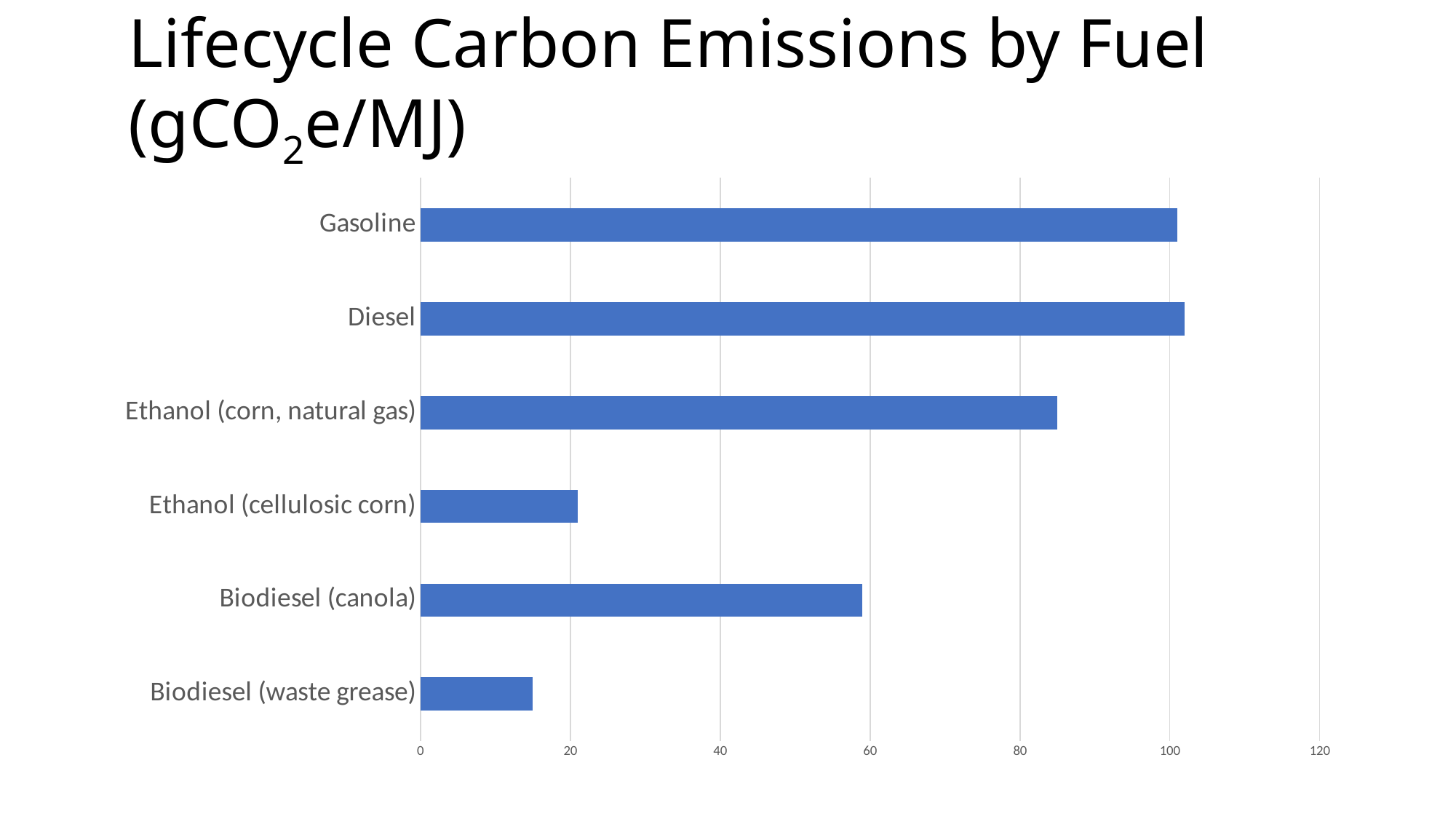
Is the value for Ethanol (corn, natural gas) greater or less than 80? greater What is the highest tick value shown on the horizontal axis? 120 How many fuel categories are plotted in the chart? 6 Which has higher emissions, Diesel or Ethanol (corn, natural gas)? Diesel Is the value for Gasoline greater or less than 80? greater Which has higher emissions, Ethanol (corn, natural gas) or Ethanol (cellulosic corn)? Ethanol (corn, natural gas) What kind of chart is shown on the slide? bar chart Which has higher emissions, Biodiesel (canola) or Biodiesel (waste grease)? Biodiesel (canola) Is the value for Ethanol (cellulosic corn) greater or less than 40? less Which fuel has the lowest lifecycle carbon emissions in the chart? Biodiesel (waste grease)